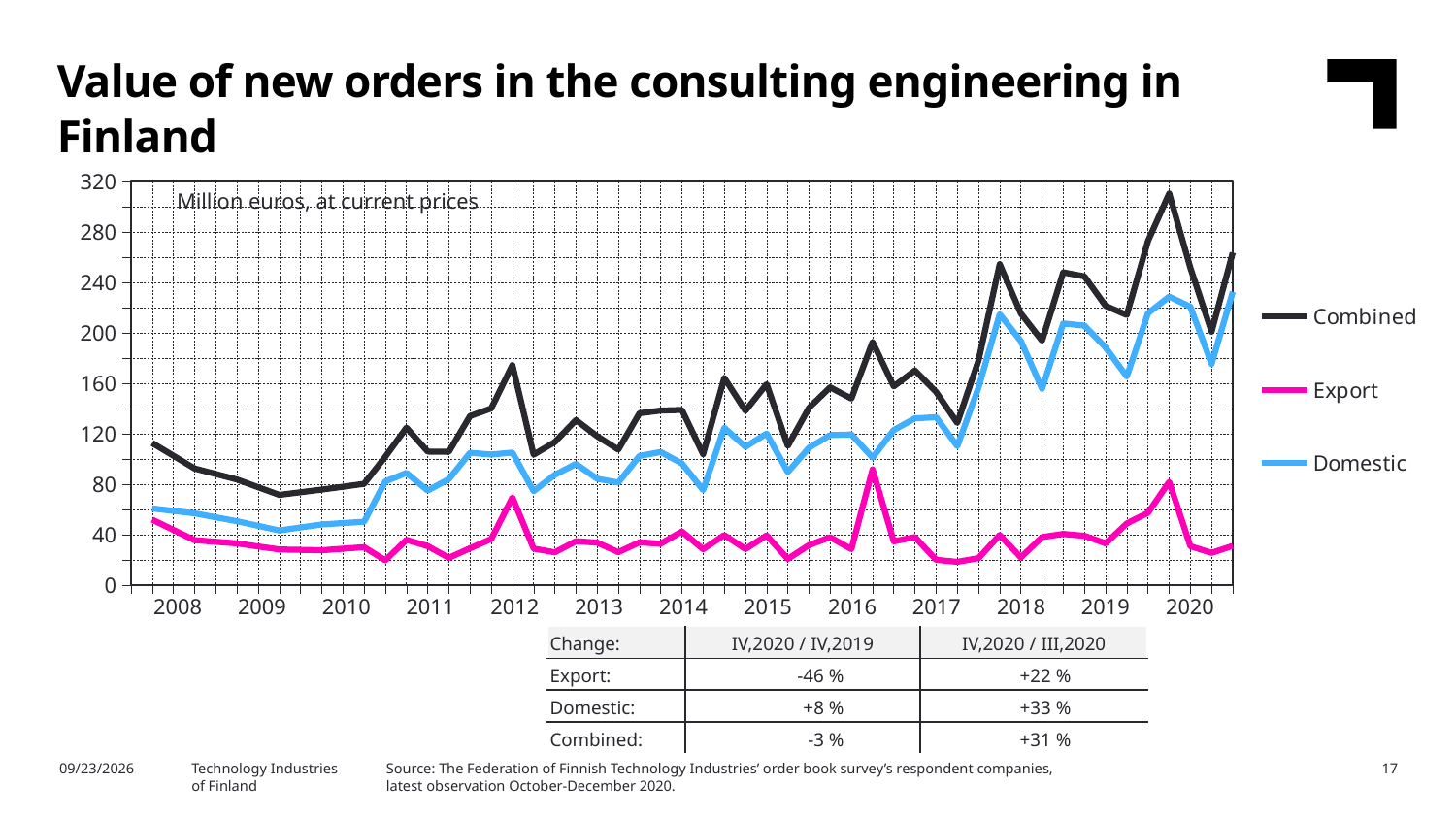
Which series has the lowest values throughout the chart? Export Which series has the highest values throughout the chart? Combined Which colour is used for the Export line? Pink (magenta) How many years are labelled on the x axis? 13 What kind of chart is shown on the slide? Line chart Is the Export value at the start of 2008 greater or less than 80? less How many series does the legend list? 3 Does the Combined line generally rise or fall from 2017 to 2019? Rise What unit is stated on the chart for the plotted values? Million euros, at current prices In 2020, which is larger, the Domestic value or the Export value? Domestic Is the highest Domestic value in 2019 greater or less than 200? greater